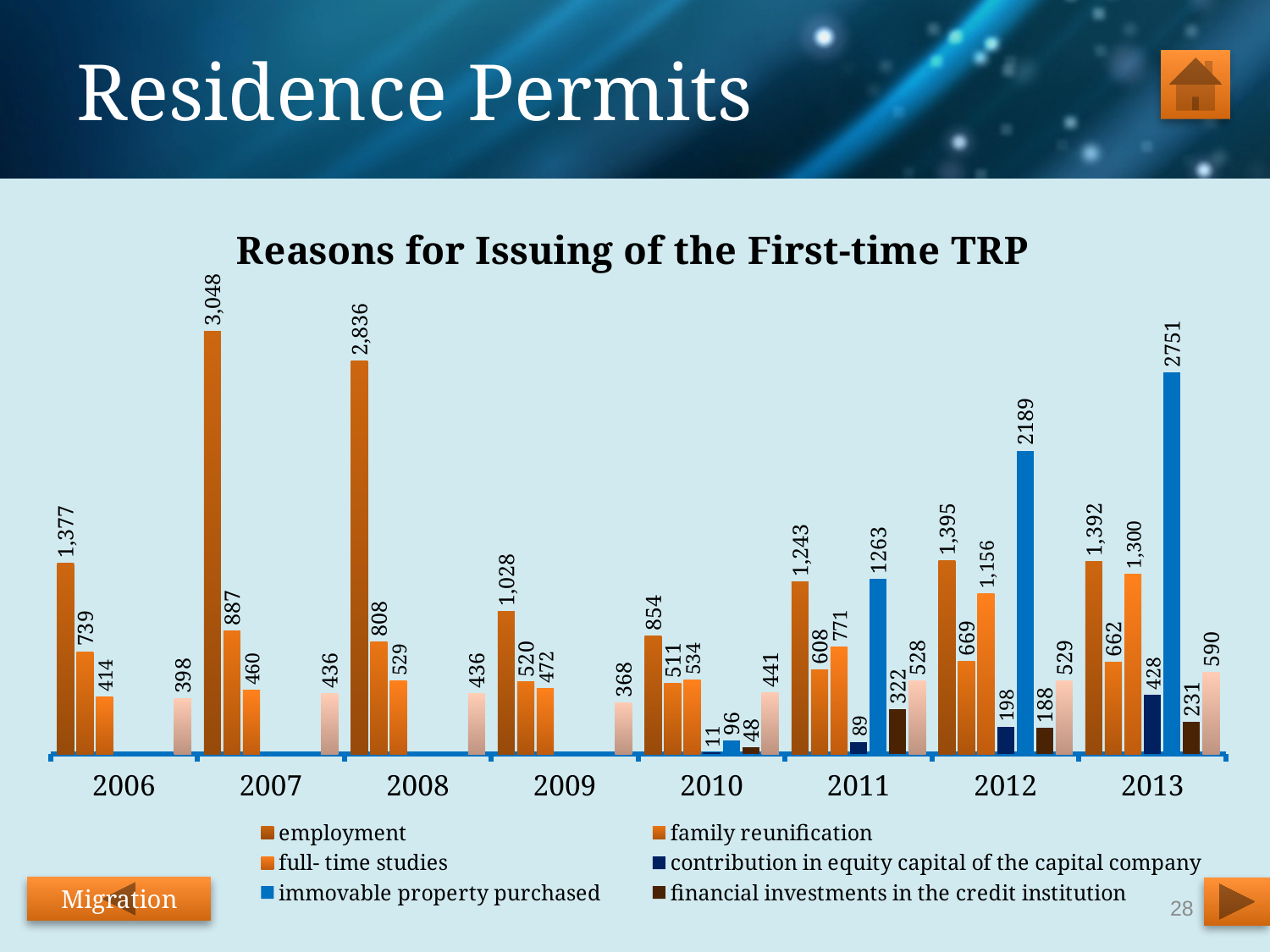
What is the difference between the employment values for 2007 and 2008? 212 What is the value for contribution in equity capital of the capital company in 2011? 89 In which year is the employment value lowest? 2010 What kind of chart is shown on the slide? bar chart How many series does the legend list? 6 How many years are shown on the x axis? 8 Does the value for immovable property purchased rise or fall from 2010 to 2013? rise What is the value for immovable property purchased in 2013? 2751 In 2012, which is larger: full-time studies or family reunification? full-time studies What is the difference between the immovable property purchased values for 2013 and 2012? 562 What is the value for employment in 2007? 3,048 In which year is the employment value highest? 2007